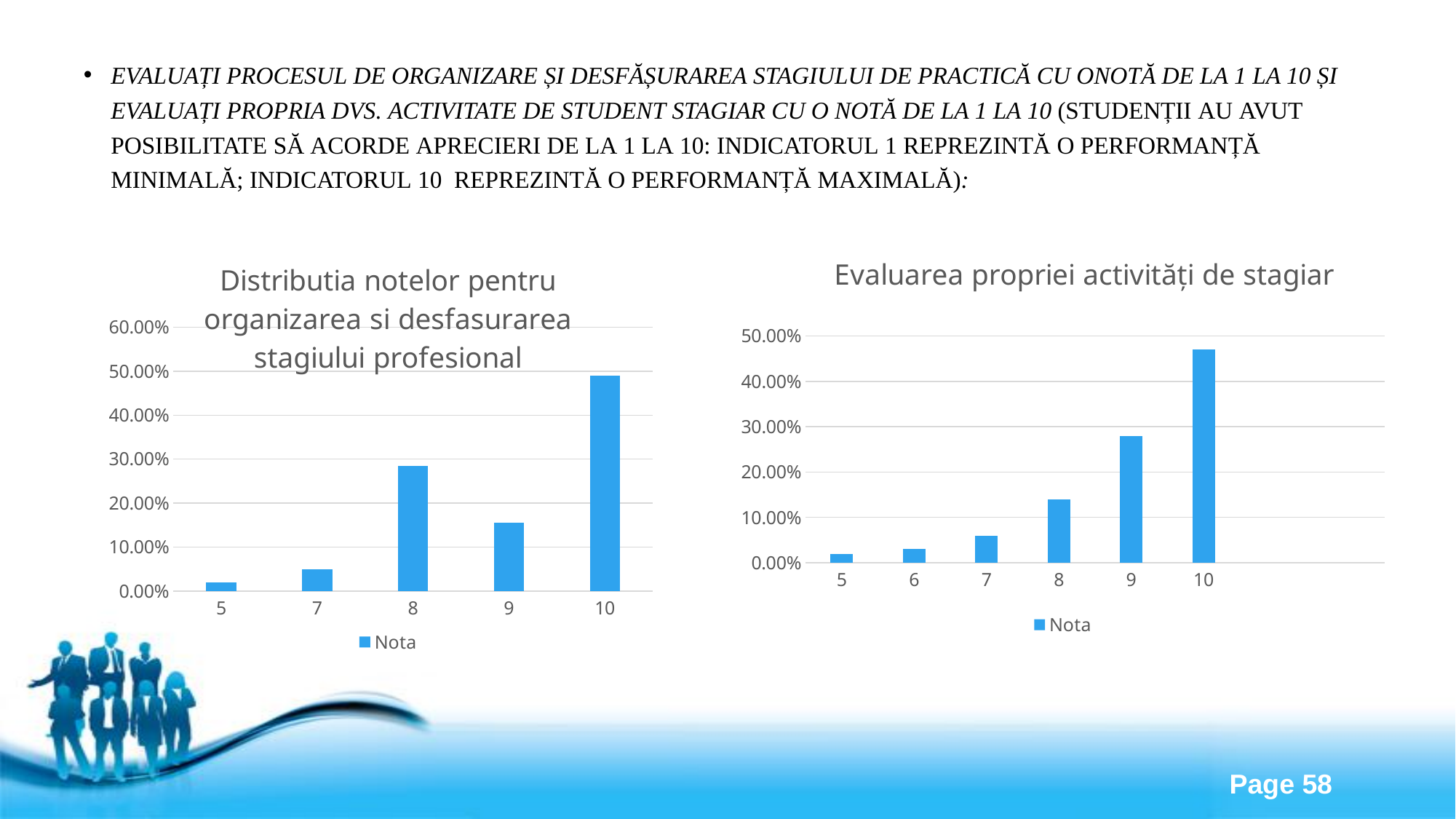
In the left chart, 'Distributia notelor pentru organizarea si desfasurarea stagiului profesional', how many grade categories are shown on the x axis? 5 What kind of chart is the left chart, 'Distributia notelor pentru organizarea si desfasurarea stagiului profesional'? Bar chart How many series does the legend of the right chart, 'Evaluarea propriei activități de stagiar', list? 1 In the right chart, 'Evaluarea propriei activități de stagiar', do the values rise or fall as the grade increases from 5 to 10? Rise In the right chart, 'Evaluarea propriei activități de stagiar', which grade has the highest share? 10 In the left chart, 'Distributia notelor pentru organizarea si desfasurarea stagiului profesional', which grade has the lowest share? 5 In the right chart, 'Evaluarea propriei activități de stagiar', which grade has the lowest share? 5 In the right chart, 'Evaluarea propriei activități de stagiar', is the value for grade 9 greater or less than 30.00%? less In the left chart, 'Distributia notelor pentru organizarea si desfasurarea stagiului profesional', which grade has the highest share? 10 In the left chart, 'Distributia notelor pentru organizarea si desfasurarea stagiului profesional', which is larger: the value for grade 8 or the value for grade 9? Grade 8 In the right chart, 'Evaluarea propriei activități de stagiar', how many grade categories are shown on the x axis? 6 In the left chart, 'Distributia notelor pentru organizarea si desfasurarea stagiului profesional', is the value for grade 10 greater or less than 40.00%? greater